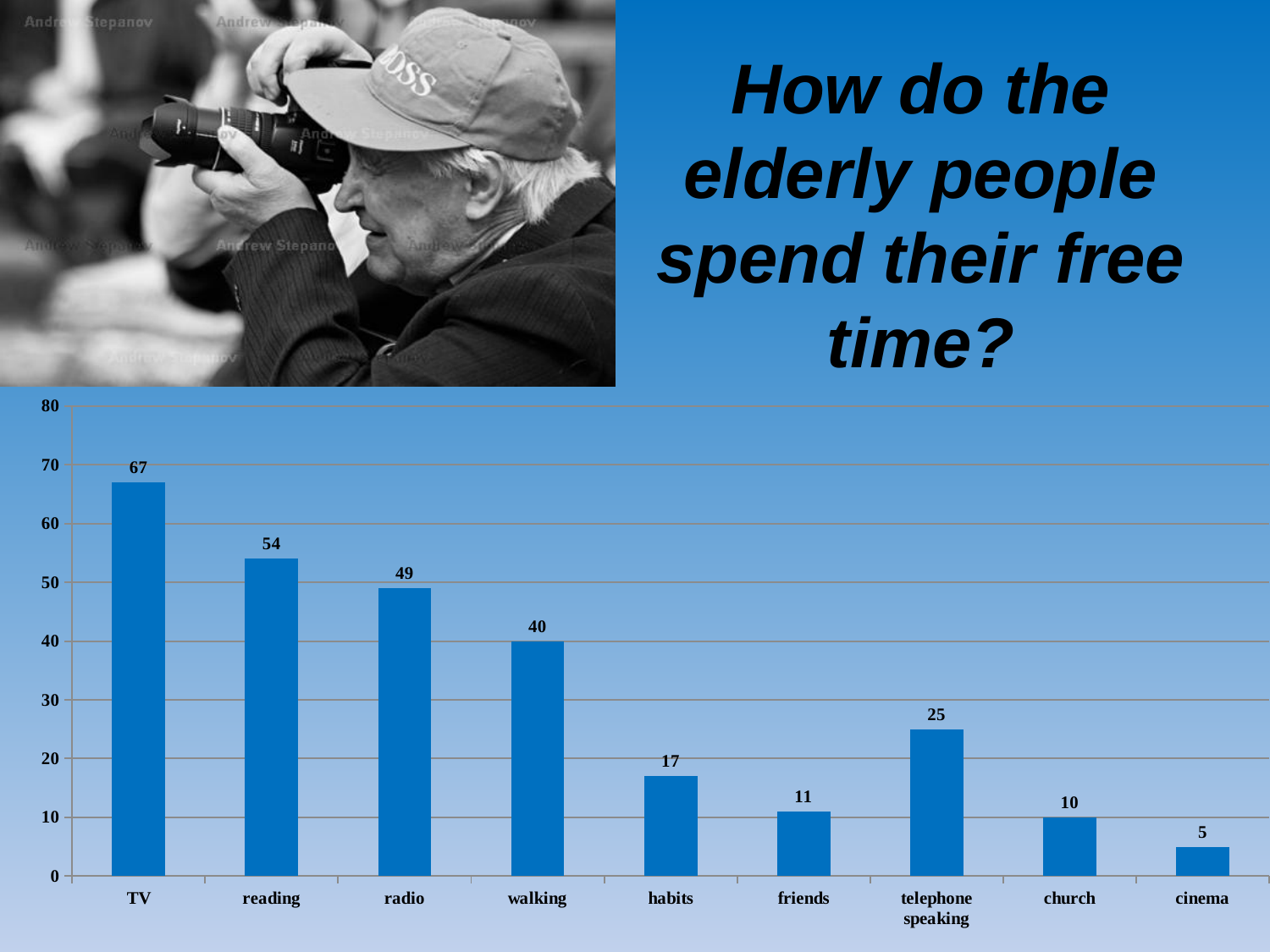
What is the value for walking? 40 Which category has the lowest value? cinema What is the title of the slide above the chart? How do the elderly people spend their free time? Which is larger, the value for habits or the value for friends? habits How many categories are shown on the x axis? 9 What is the difference between the values for TV and cinema? 62 What is the value for TV? 67 What is the value for telephone speaking? 25 Which category has the highest value? TV Is the value for church greater or less than 20? less What kind of chart is shown on the slide? bar chart What is the difference between the values for reading and radio? 5